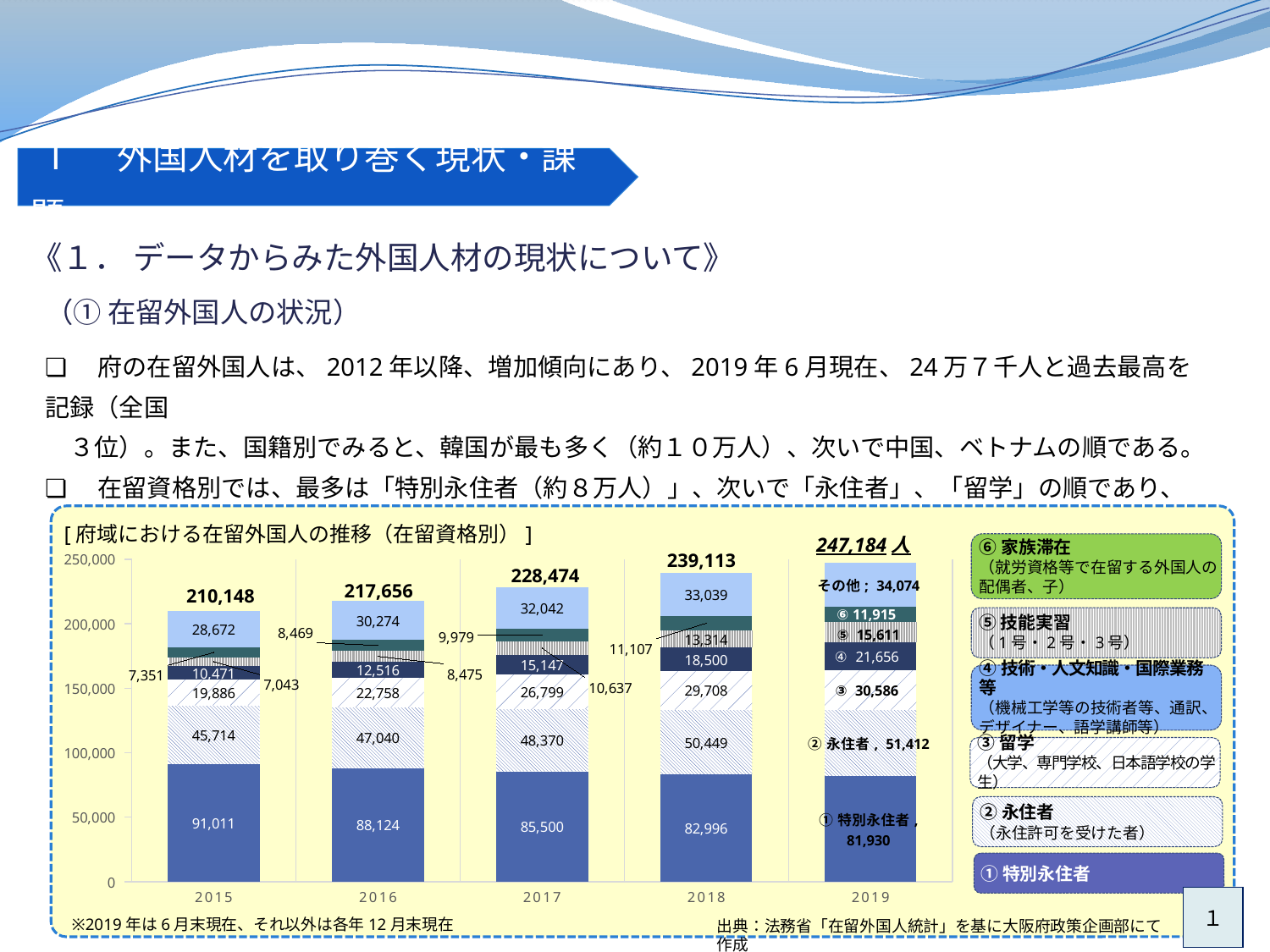
2019年と2018年の総数の差はいくらですか？ 8,071 2015年と2019年では、「特別永住者」の値はどちらが大きいですか？ 2015 在留外国人の総数が最も多い年はどれですか？ 2019 これはどの種類のグラフですか？ 積み上げ棒グラフ 在留外国人の総数が最も少ない年はどれですか？ 2015 2015年の在留外国人の総数はいくらですか？ 210,148 2015年から2019年にかけて、在留外国人の総数は増加していますか、減少していますか？ 増加 2019年の「技能実習」の値はいくらですか？ 15,611 2019年の在留外国人の総数はいくらですか？ 247,184人 2019年の「特別永住者」の値はいくらですか？ 81,930 2017年の「永住者」の値はいくらですか？ 48,370 このグラフには何年分のデータが示されていますか？ 5